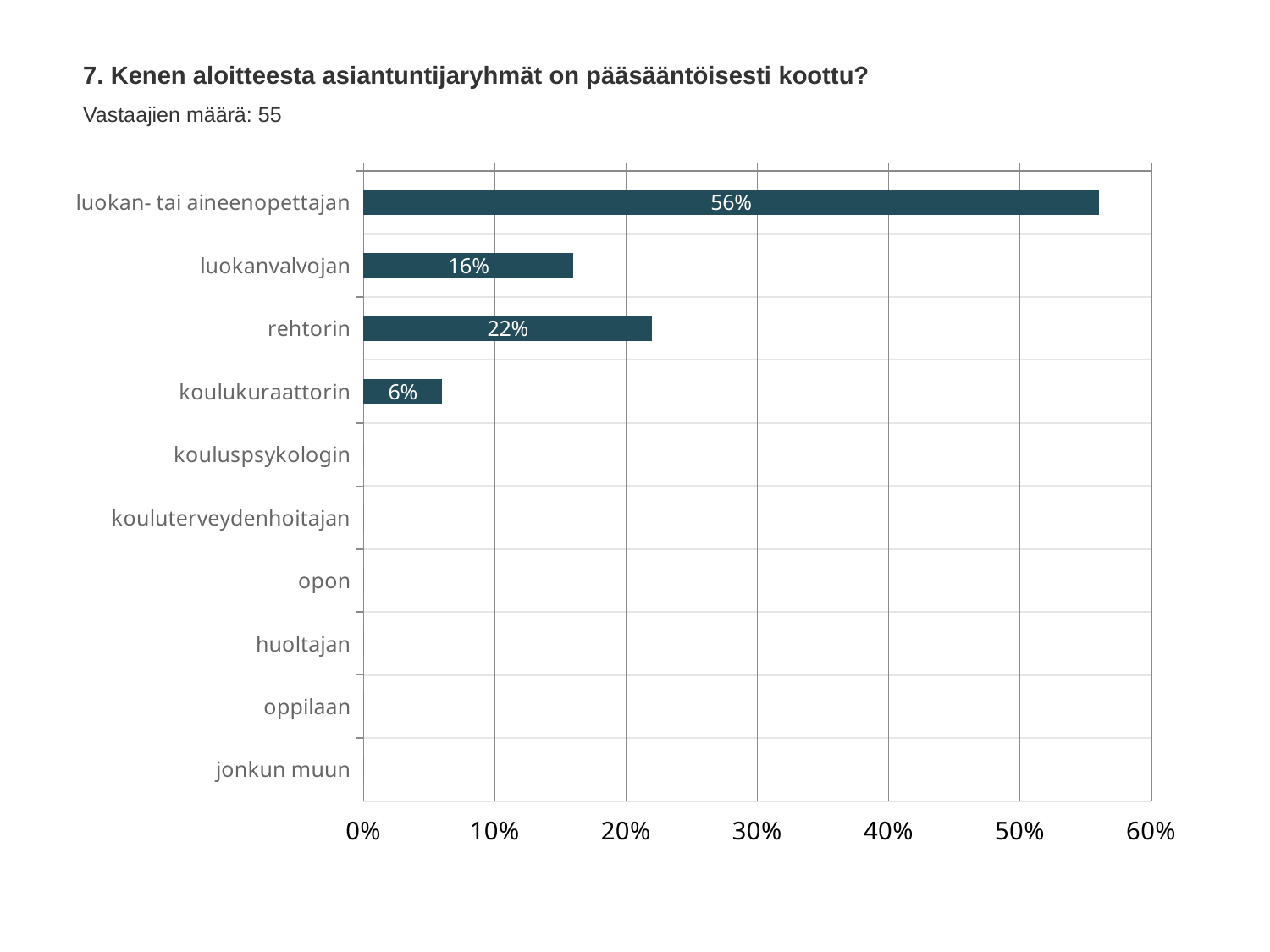
What is the value for luokanvalvojan? 16% What is the difference between the values for rehtorin and luokanvalvojan? 6% What is the difference between the values for luokan- tai aineenopettajan and rehtorin? 34% Is the value for luokan- tai aineenopettajan greater or less than 50%? greater What kind of chart is shown on the slide? bar chart Which category has the highest value? luokan- tai aineenopettajan What is the value for rehtorin? 22% What is the value for luokan- tai aineenopettajan? 56% Which is larger, the value for rehtorin or the value for luokanvalvojan? rehtorin How many respondents (Vastaajien määrä) are stated on the slide? 55 How many categories are listed on the vertical axis? 10 What is the value for koulukuraattorin? 6%